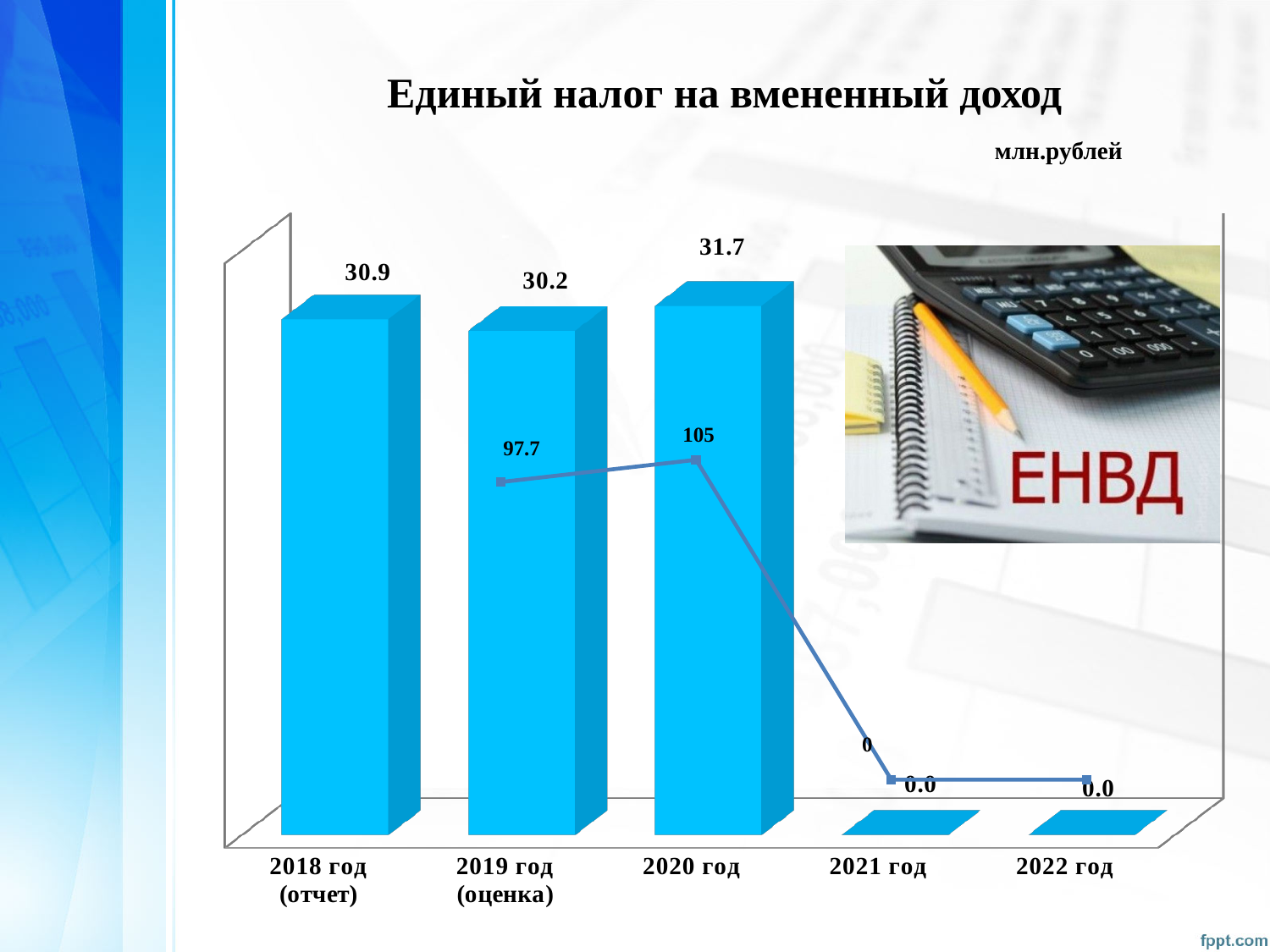
What is the value of the line point at 2020 год? 105 What is the difference between the bar values for 2020 год and 2019 год (оценка)? 1.5 Which year has the highest bar value? 2020 год What is the value of the line point at 2019 год (оценка)? 97.7 What is the value of the bar for 2019 год (оценка)? 30.2 Which bar is larger, 2018 год (отчет) or 2019 год (оценка)? 2018 год (отчет) What is the value of the bar for 2018 год (отчет)? 30.9 How many year categories are shown on the x axis? 5 What unit of measurement is indicated for the chart? млн.рублей What is the value of the bar for 2020 год? 31.7 What is the value of the bar for 2022 год? 0.0 What is the title of the chart? Единый налог на вмененный доход